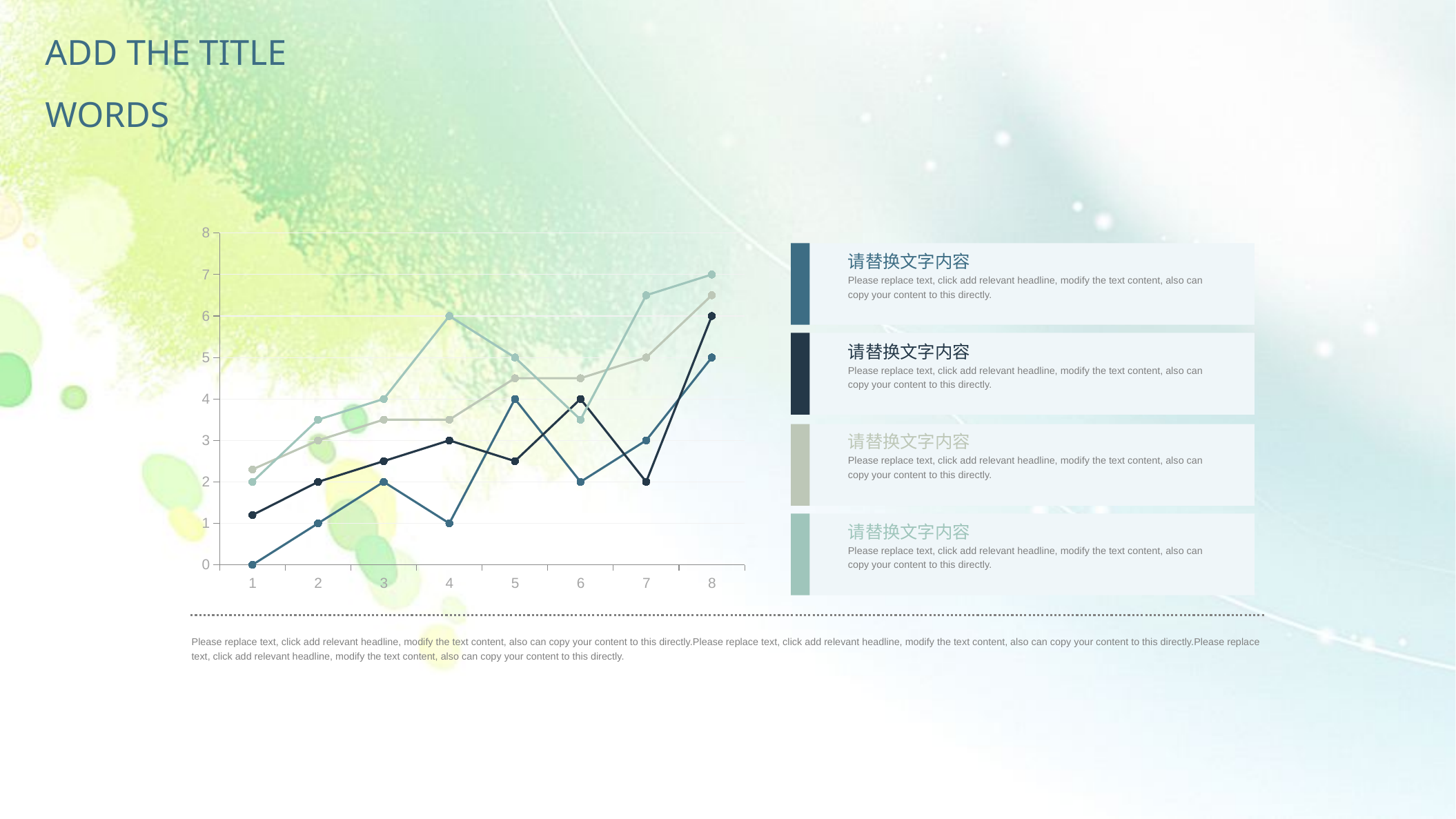
What kind of chart is shown on the slide? line chart What is the value of the medium blue line at x = 1? 0 How many lines are plotted on the chart? 4 What is the difference between the dark navy line's value at x = 8 and its value at x = 2? 4 At x = 8, which line is higher: the light teal line or the dark navy line? light teal line How many points are labelled along the x axis of the chart? 8 What is the value of the dark navy line at x = 8? 6 At which x value does the light teal line reach its highest point? 8 What is the value of the medium blue line at x = 5? 4 Is the value of the grey-beige line at x = 8 greater or less than 6? greater At which x value does the medium blue line reach its lowest point? 1 What is the value of the light teal line at x = 8? 7